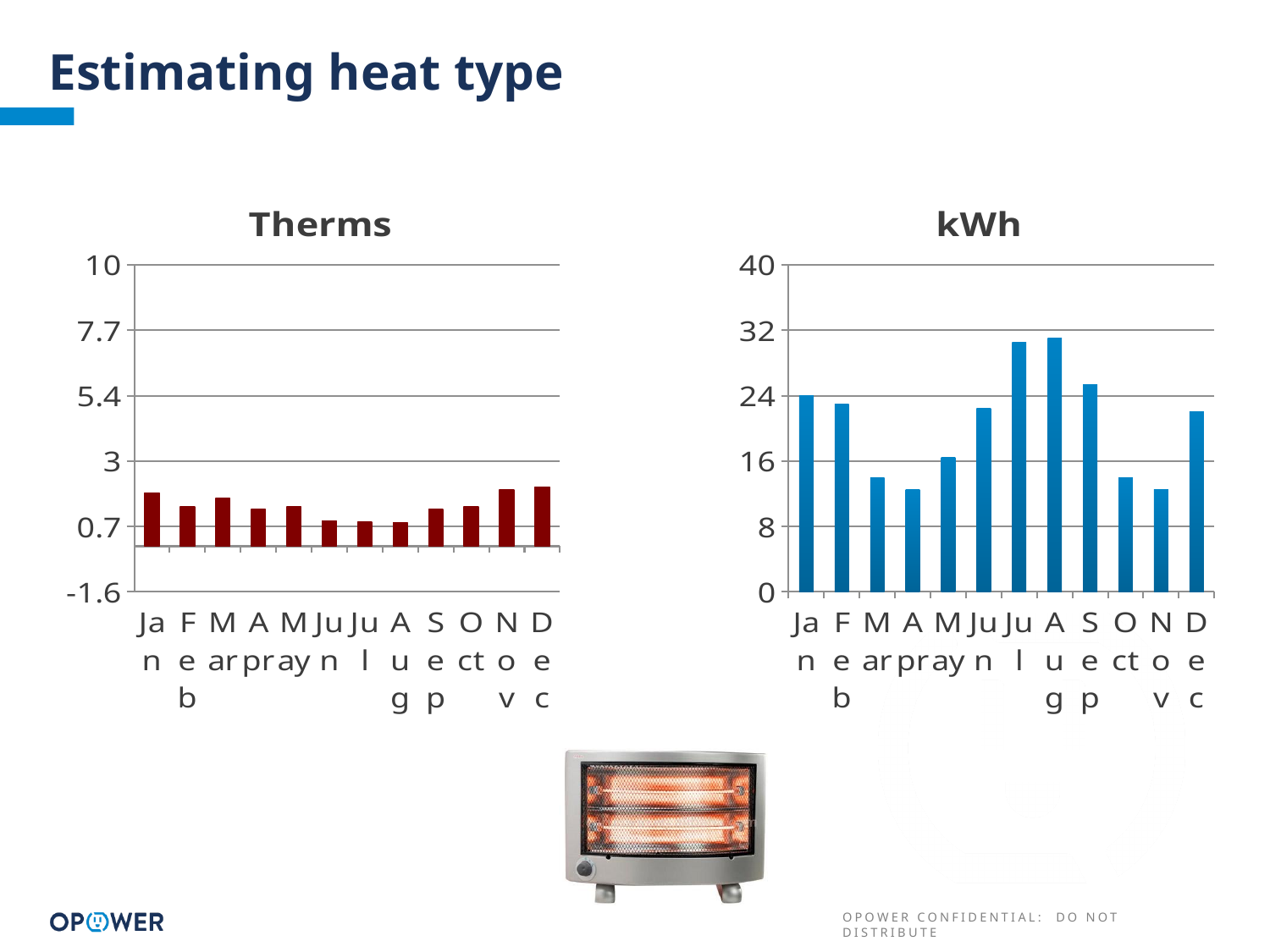
On the kWh chart, is the value for Jan greater or less than 16? greater What colour are the bars in the Therms chart? dark red On the kWh chart, is the value for Jul greater or less than 24? greater On the Therms chart, is the value for Dec greater or less than 3? less On the Therms chart, which is larger, the value for Dec or the value for Jul? Dec How many categories does the Therms chart show on its x axis? 12 On the kWh chart, which is larger, the value for Jul or the value for Mar? Jul What is the title of the chart on the right side of the slide? kWh What kind of chart is the Therms chart? bar chart How many months are plotted on the kWh chart? 12